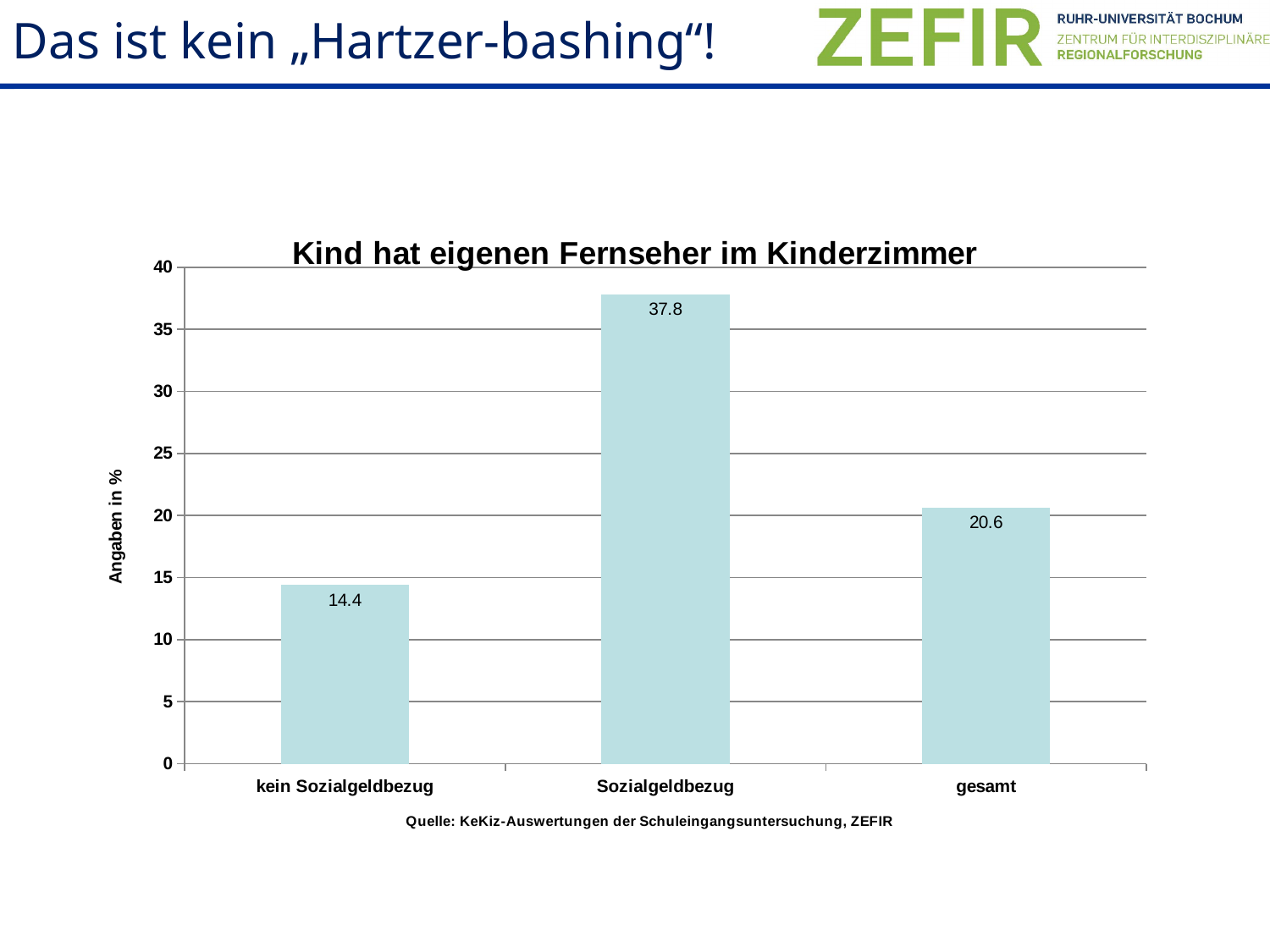
What is the value for "kein Sozialgeldbezug"? 14.4 Is the value for "Sozialgeldbezug" greater or less than 35? greater What is the difference between the values for "gesamt" and "kein Sozialgeldbezug"? 6.2 What kind of chart is shown on the slide? bar chart What is the difference between the values for "Sozialgeldbezug" and "kein Sozialgeldbezug"? 23.4 How many categories are shown on the x axis? 3 What is the value for "gesamt"? 20.6 What is the title of the chart? Kind hat eigenen Fernseher im Kinderzimmer What is the value for "Sozialgeldbezug"? 37.8 Which is larger, the value for "gesamt" or the value for "kein Sozialgeldbezug"? gesamt Which category has the lowest value? kein Sozialgeldbezug Which category has the highest value? Sozialgeldbezug